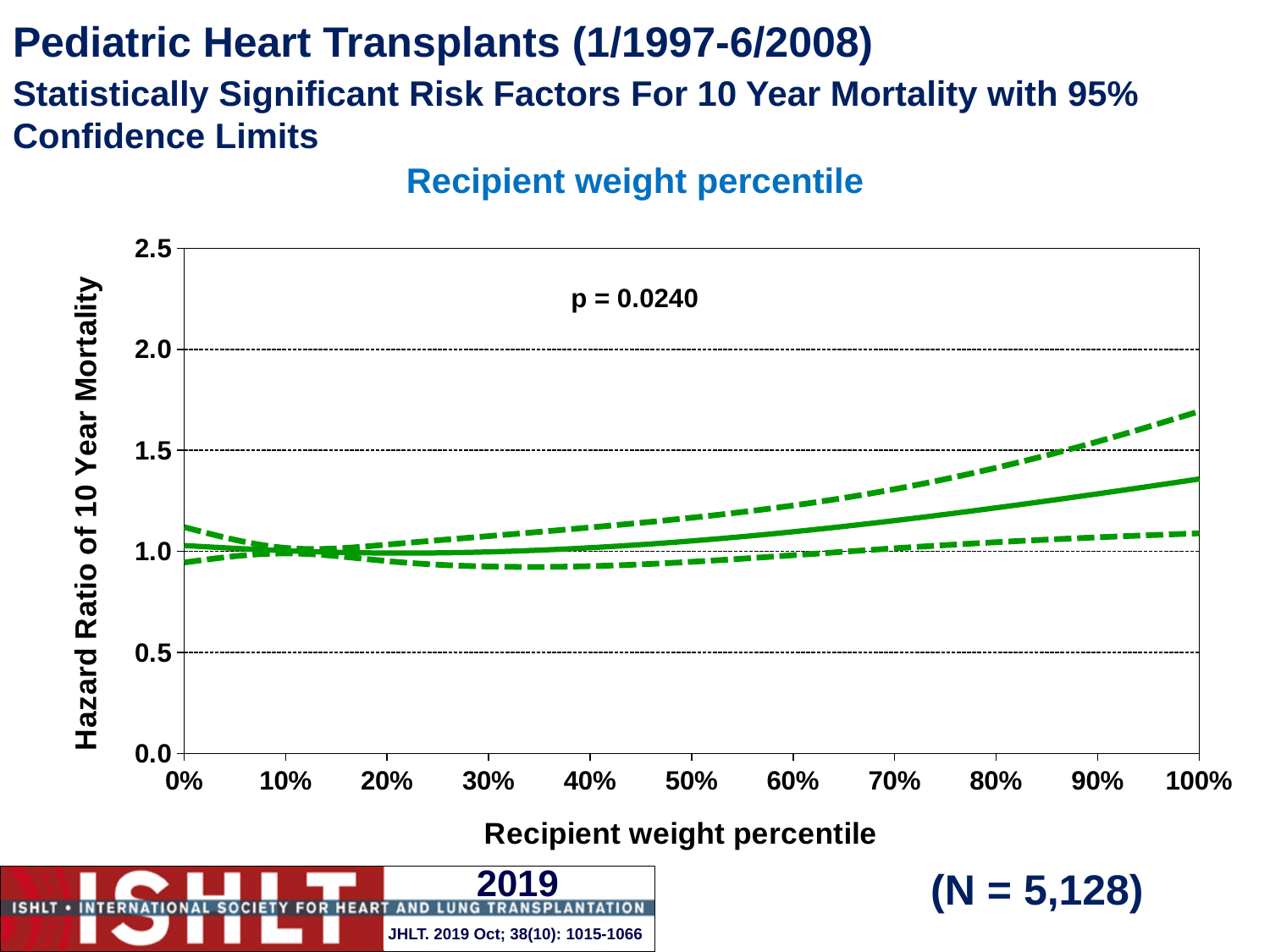
Is the upper dashed confidence limit at 100% recipient weight percentile greater or less than 1.5? greater What p-value is printed on the chart? p = 0.0240 What kind of chart is shown on the slide? line chart What is the sample size (N) shown on the slide? N = 5,128 Is the value of the solid hazard ratio line at 100% recipient weight percentile greater or less than 1.5? less Is the solid hazard ratio line at 10% recipient weight percentile greater or less than 1.5? less How many tick labels are shown on the x axis of the chart? 11 How many lines are plotted on the chart? 3 Does the solid hazard ratio line rise or fall as recipient weight percentile increases from 0% to 100%? rise